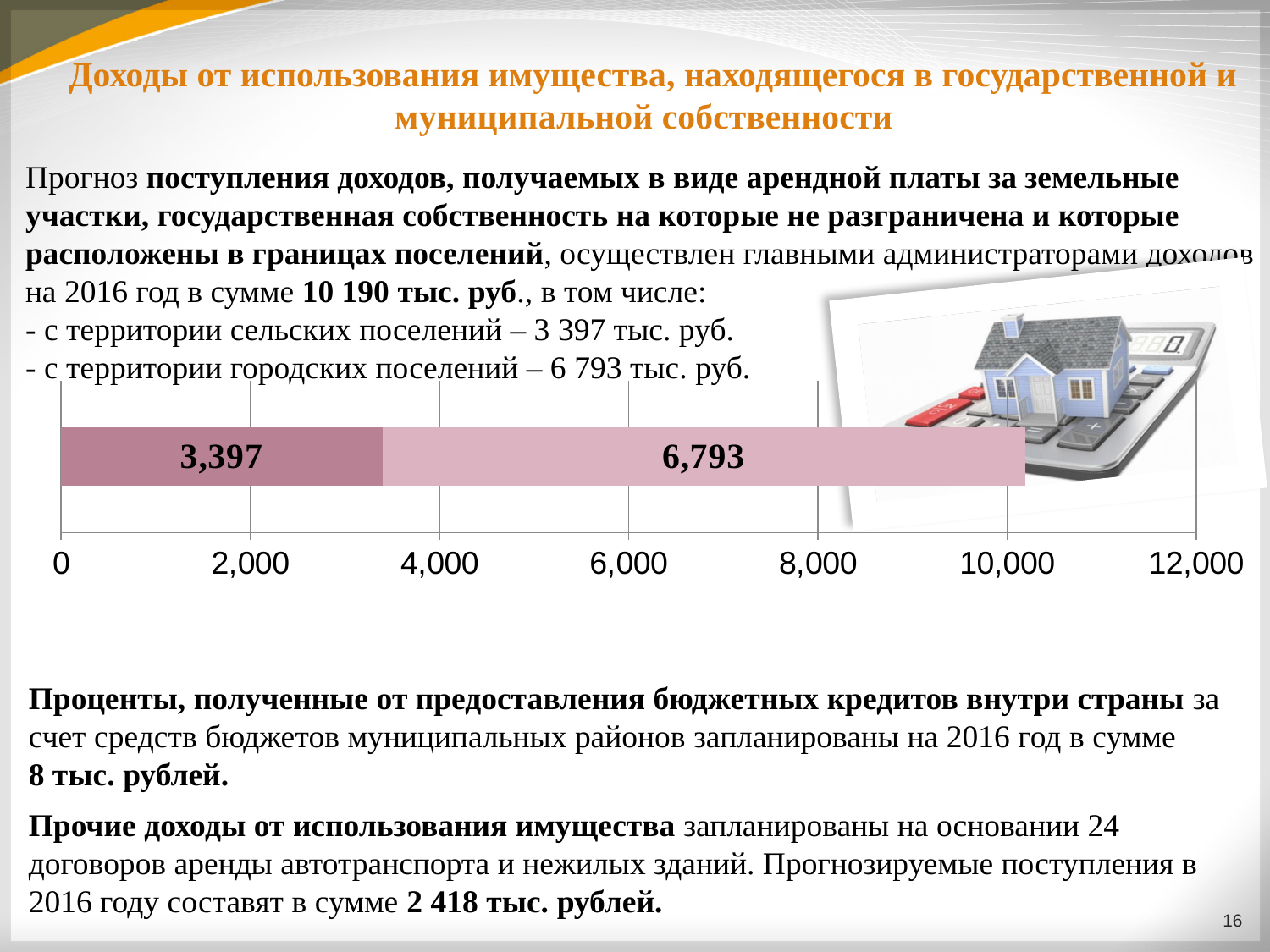
How many segments does the stacked bar contain? 2 What kind of chart is shown on the slide? bar chart Is the value of the left segment of the bar greater or less than 4,000? less What is the value printed on the left (darker) segment of the bar? 3,397 What is the difference between the two segment values, 6,793 and 3,397? 3,396 What is the value printed on the right (lighter) segment of the bar? 6,793 What is the total of the stacked bar (3,397 + 6,793)? 10,190 Does the full stacked bar end at a value greater or less than 8,000? greater What is the largest value shown on the horizontal axis of the chart? 12,000 Which segment value is the smallest in the bar? 3,397 Which segment of the bar is larger, the left one (3,397) or the right one (6,793)? the right one (6,793) What is the interval between consecutive tick labels on the horizontal axis? 2,000